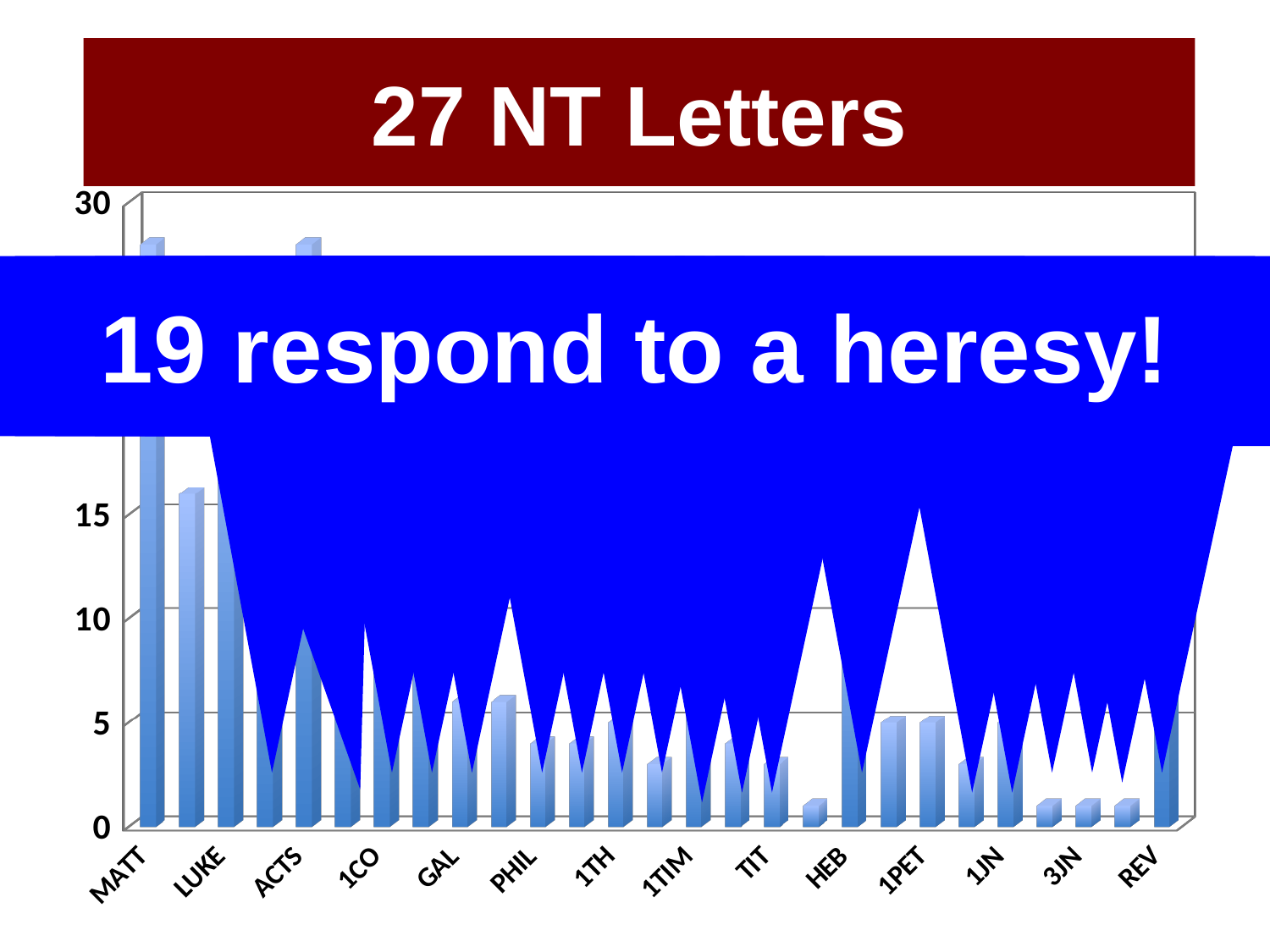
Which is larger, the value for HEB or the value for 3JN? HEB Is the value for MATT greater or less than 15? greater Is the value for HEB greater or less than 10? greater Is the value for ACTS greater or less than 15? greater What kind of chart is shown on the slide? bar chart Which is larger, the value for MATT or the value for GAL? MATT How many bars are plotted in the chart? 27 What is the title shown above the chart? 27 NT Letters